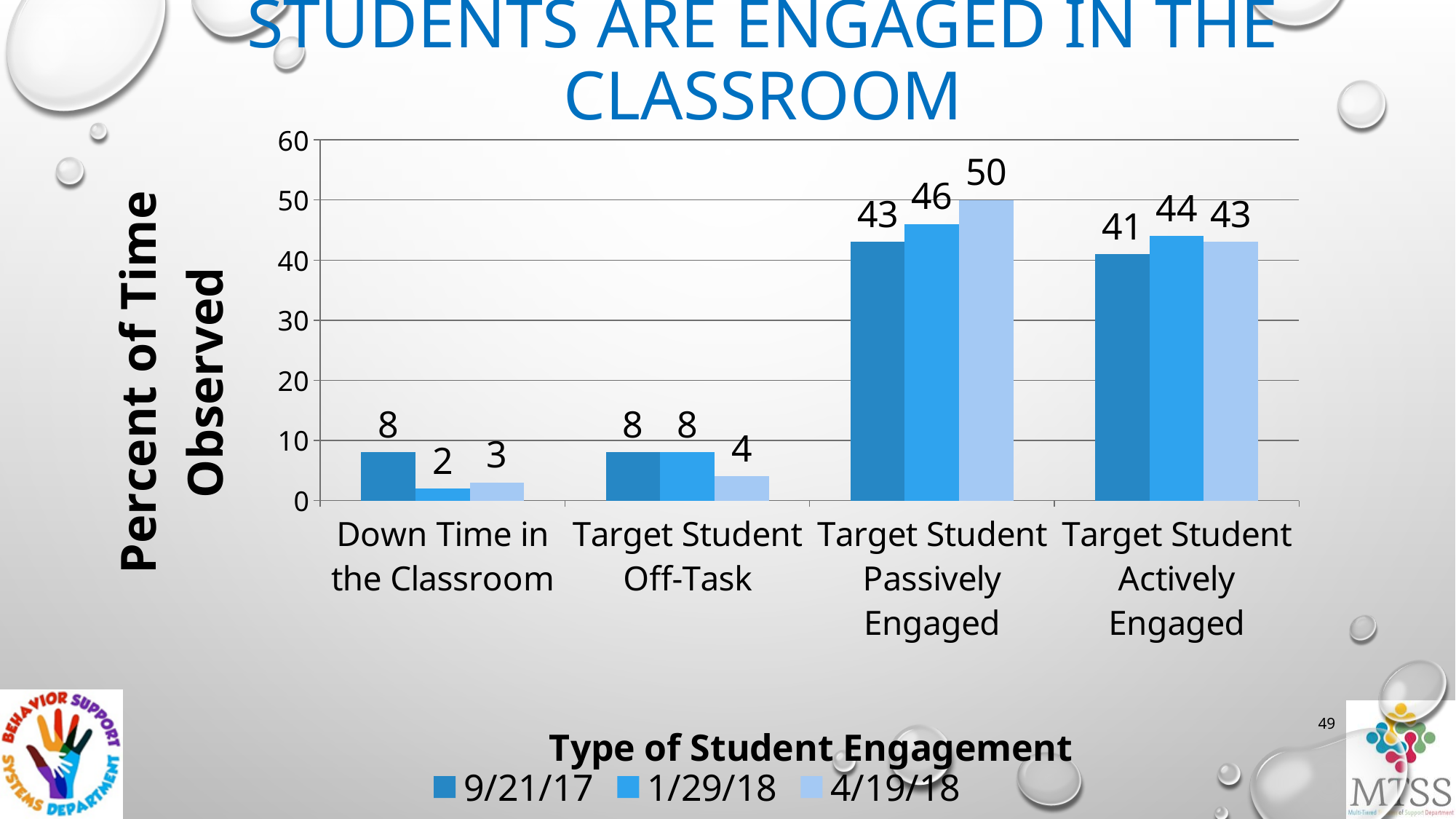
What kind of chart is shown on the slide? Bar chart Which is larger for Target Student Off-Task: the 9/21/17 value or the 4/19/18 value? 9/21/17 What is the value for Target Student Actively Engaged in the 9/21/17 series? 41 What is the difference between the 4/19/18 and 9/21/17 values for Target Student Passively Engaged? 7 What is the value for Down Time in the Classroom in the 1/29/18 series? 2 What is the value for Target Student Passively Engaged in the 4/19/18 series? 50 How many series does the legend list? 3 How many categories are shown on the x axis? 4 What is the title of the y axis? Percent of Time Observed Which category has the highest value in the 4/19/18 series? Target Student Passively Engaged Is the value for Target Student Actively Engaged in the 1/29/18 series greater or less than 40? greater Which category has the lowest value in the 1/29/18 series? Down Time in the Classroom